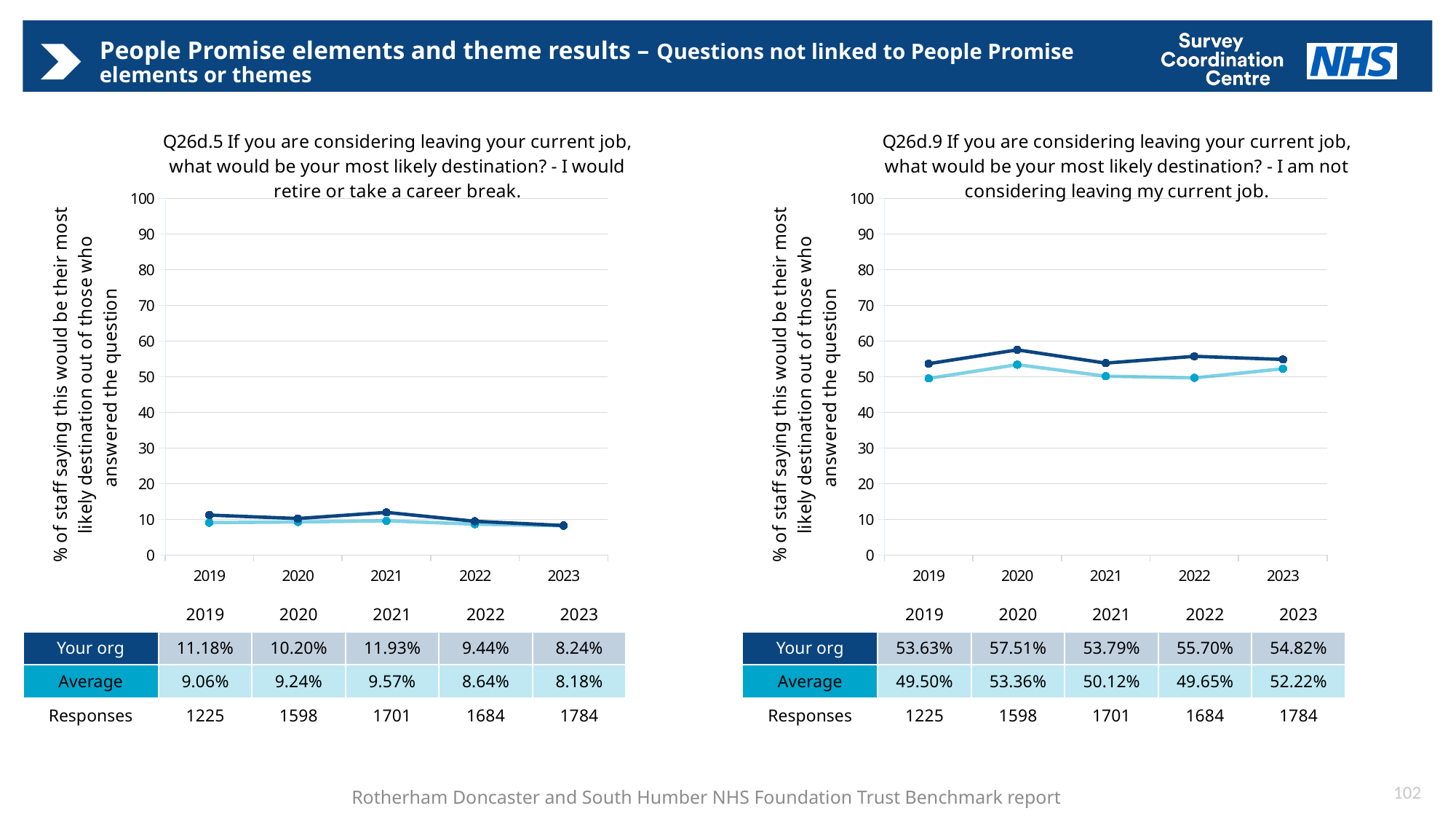
In the Q26d.9 chart (right), what is the difference between the Your org and Average values for 2019? 4.13% In the Q26d.5 chart (left), which year has the lowest Your org value? 2023 What type of chart is the Q26d.9 chart (right)? line chart In the Q26d.9 chart (right), is the Average value for 2021 greater or less than 60? less How many years are plotted on the x axis of the Q26d.5 chart (left)? 5 In the Q26d.5 chart (left), what is the Your org value for 2021? 11.93% In the Q26d.9 chart (right), is the Your org value for 2022 larger or smaller than the Average value for 2022? larger In the Q26d.5 chart (left), does the Your org line rise or fall from 2021 to 2023? fall In the Q26d.9 chart (right), which year has the highest Your org value? 2020 In the Q26d.9 chart (right), what is the Average value for 2020? 53.36% How many responses are shown for 2023 in the Q26d.9 chart (right)? 1784 In the Q26d.5 chart (left), what is the difference between the Your org values for 2021 and 2023? 3.69%